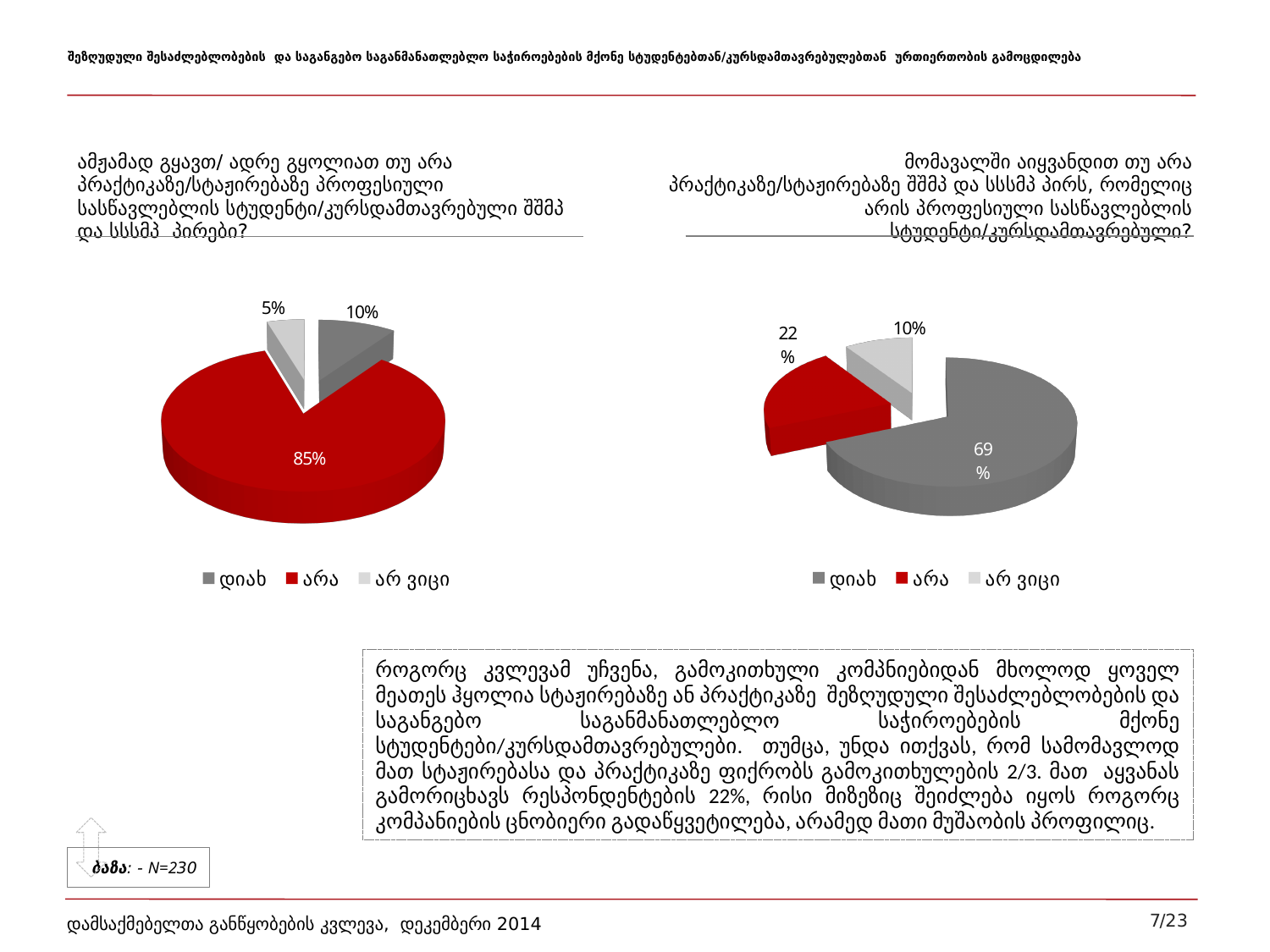
In the left pie chart, what percentage is shown for the slice labelled "არა"? 85% In the right pie chart, what percentage is shown for the slice labelled "არა"? 22% In the right pie chart, what percentage is shown for the slice labelled "დიახ"? 69% In the right pie chart, which category has the smallest share? არ ვიცი In the left pie chart, what percentage is shown for the slice labelled "დიახ"? 10% What type of chart is used on the left side of the slide? Pie chart In the right pie chart, what percentage is shown for the slice labelled "არ ვიცი"? 10% In the left pie chart, which category has the largest share? არა In the left pie chart, what percentage is shown for the slice labelled "არ ვიცი"? 5% How many categories does the legend of the left pie chart list? 3 What is the difference in percentage points between the "დიახ" slice in the right pie chart and the "დიახ" slice in the left pie chart? 59 In the right pie chart, which is larger: the "დიახ" slice or the "არა" slice? დიახ